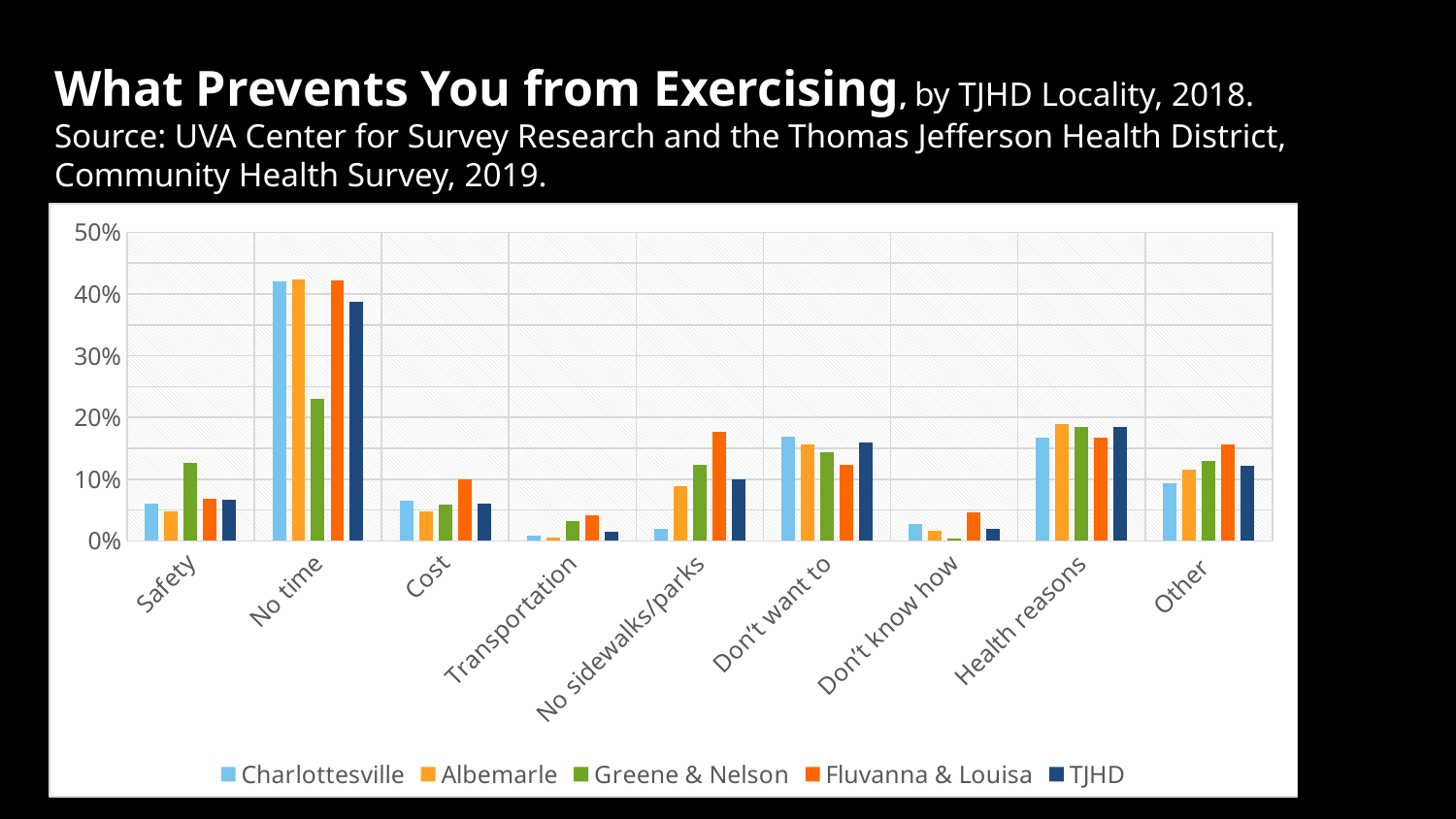
How many categories (reasons) are shown on the x axis? 9 Is the Charlottesville value for Cost greater or less than 10%? less Within the Safety category, which locality has the highest bar? Greene & Nelson For Greene & Nelson, which reason has the lowest value? Don't know how Which reason has the highest value for every locality? No time Within the No sidewalks/parks category, which locality has the highest bar? Fluvanna & Louisa For No time, which is larger: the Albemarle value or the Greene & Nelson value? Albemarle Is the Fluvanna & Louisa value for No sidewalks/parks greater or less than 10%? greater Which locality is shown in the darkest blue bars according to the legend? TJHD What kind of chart is shown on the slide? bar chart How many series does the legend list? 5 Is the Greene & Nelson value for No time greater or less than 20%? greater